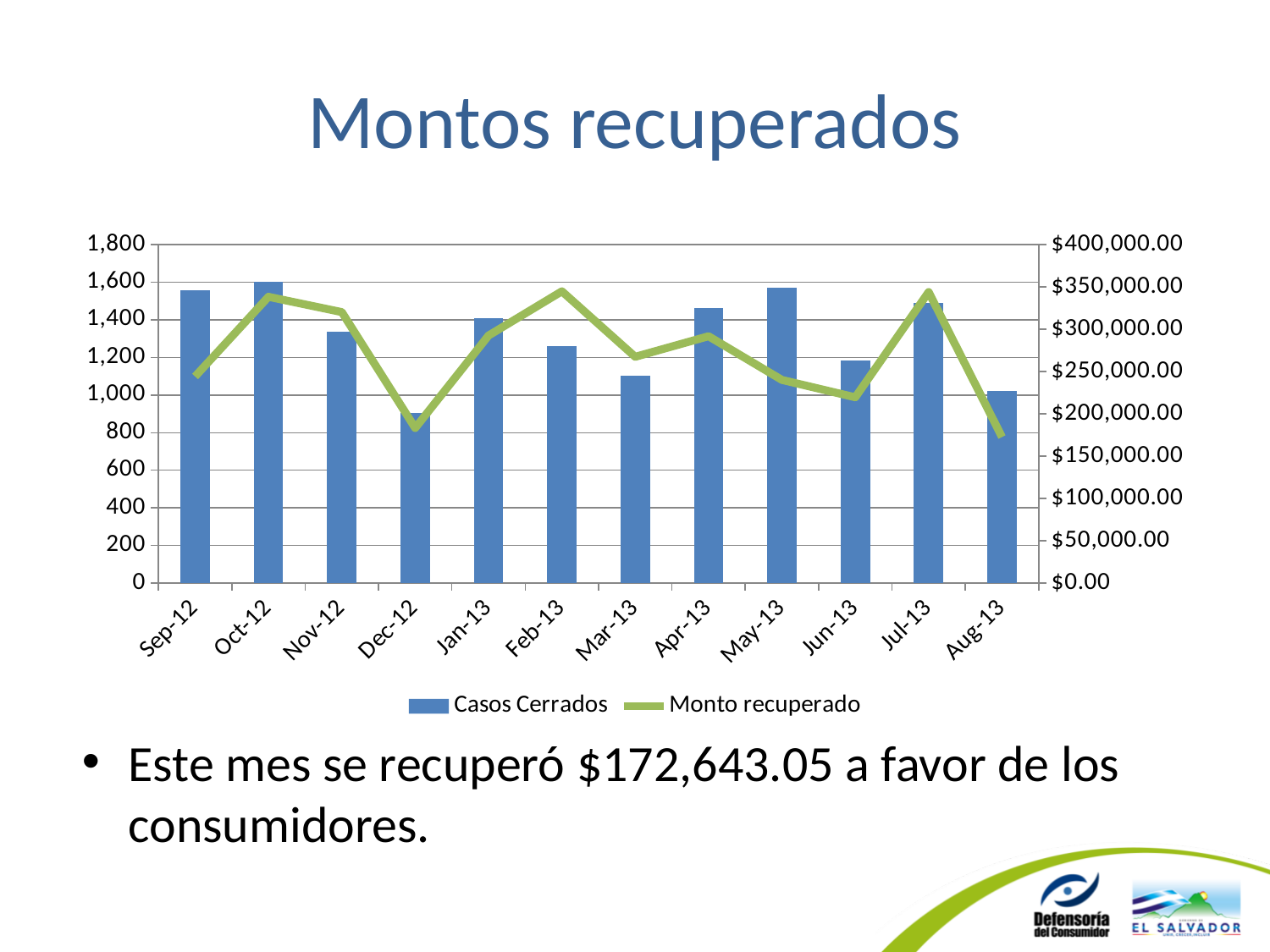
Which has more Casos Cerrados, Dec-12 or Jan-13? Jan-13 Is the Casos Cerrados value for Oct-12 greater or less than 1,400? greater Which month has the lowest Casos Cerrados bar? Dec-12 What is the title of the chart on the slide? Montos recuperados How many series does the chart legend list? 2 What kind of chart is shown on the slide? A combined bar and line chart Is the Monto recuperado value for Aug-13 greater or less than $200,000.00? less Is the Casos Cerrados value for Dec-12 greater or less than 1,000? less How many months are shown on the x axis of the chart? 12 Which has more Casos Cerrados, Mar-13 or Apr-13? Apr-13 Does the Monto recuperado line rise or fall from Jul-13 to Aug-13? fall